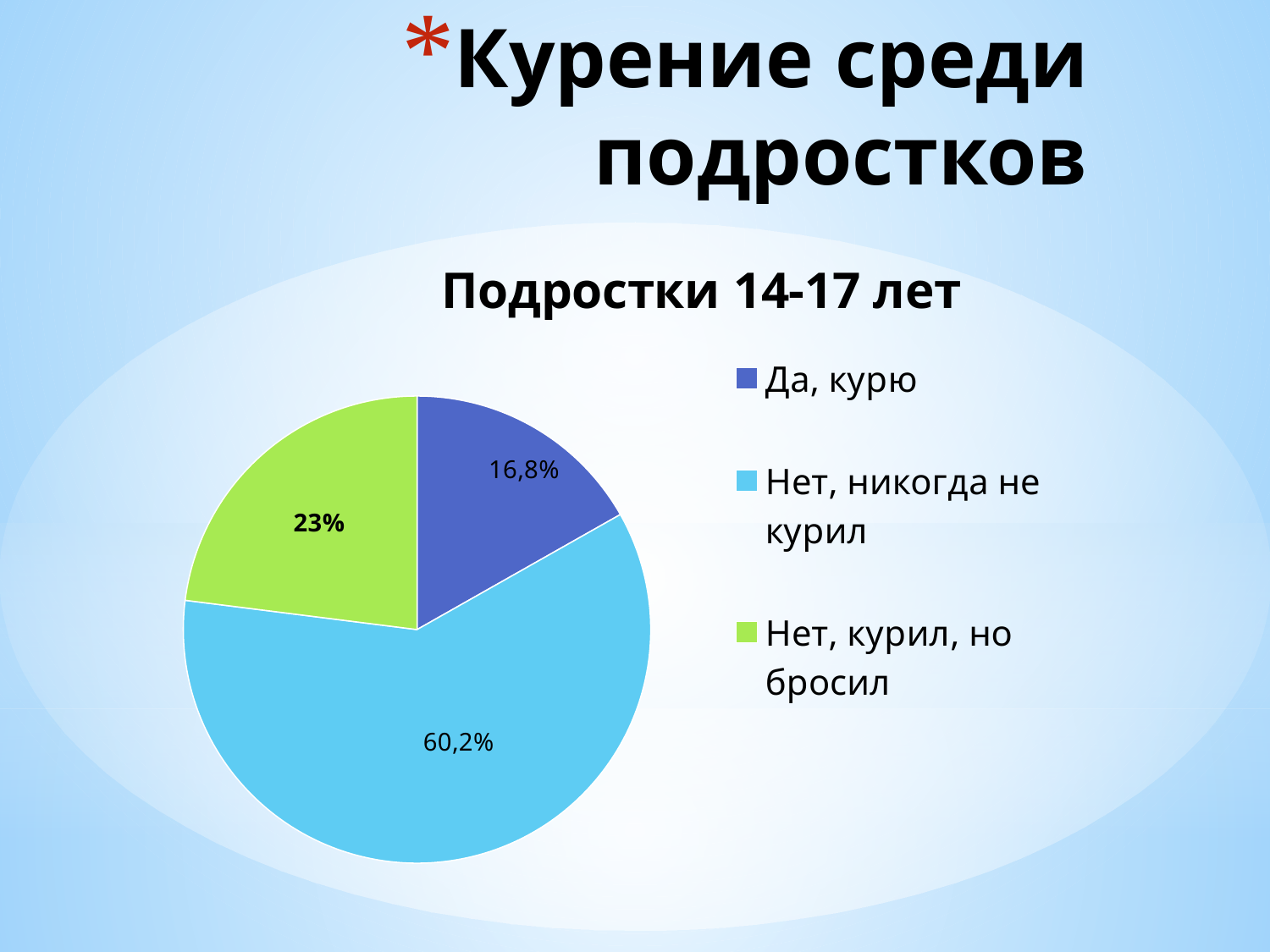
What percentage of the pie is labelled for "Нет, курил, но бросил"? 23% Which category has the smallest share of the pie? Да, курю Which category has the largest share of the pie? Нет, никогда не курил What type of chart is shown on the slide? pie chart What percentage of the pie is labelled for "Нет, никогда не курил"? 60,2% Which is larger: the share for "Да, курю" or the share for "Нет, курил, но бросил"? Нет, курил, но бросил What is the difference between the share for "Нет, никогда не курил" and the share for "Нет, курил, но бросил"? 37,2% What colour is the slice for "Нет, курил, но бросил"? green What is the difference between the share for "Нет, курил, но бросил" and the share for "Да, курю"? 6,2% What percentage of the pie is labelled for "Да, курю"? 16,8% How many categories does the legend list? 3 What is the title of the chart? Подростки 14-17 лет